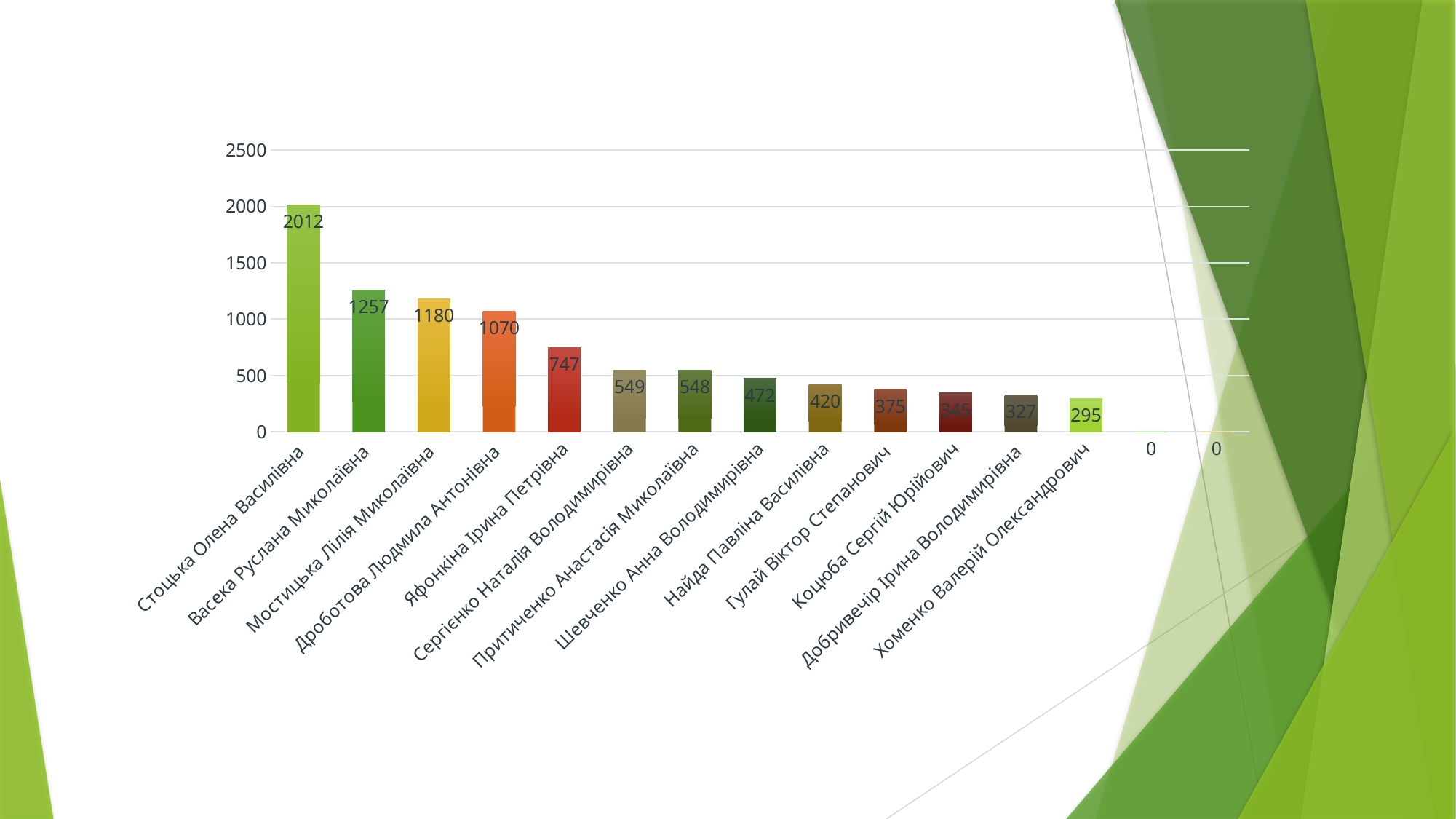
Is the value for Дроботова Людмила Антонівна greater or less than 1000? greater What is the difference between the values for Стоцька Олена Василівна and Васека Руслана Миколаївна? 755 What is the value for Хоменко Валерій Олександрович? 295 What is the value for Стоцька Олена Василівна? 2012 What is the highest value shown on the vertical axis? 2500 Which person has the highest value in the chart? Стоцька Олена Василівна What kind of chart is shown on the slide? bar chart Do the values rise or fall moving from left to right along the x axis? fall What is the value for Яфонкіна Ірина Петрівна? 747 What is the value for Найда Павліна Василівна? 420 What is the difference between the values for Сергієнко Наталія Володимирівна and Притиченко Анастасія Миколаївна? 1 Which is larger, the value for Яфонкіна Ірина Петрівна or the value for Сергієнко Наталія Володимирівна? Яфонкіна Ірина Петрівна